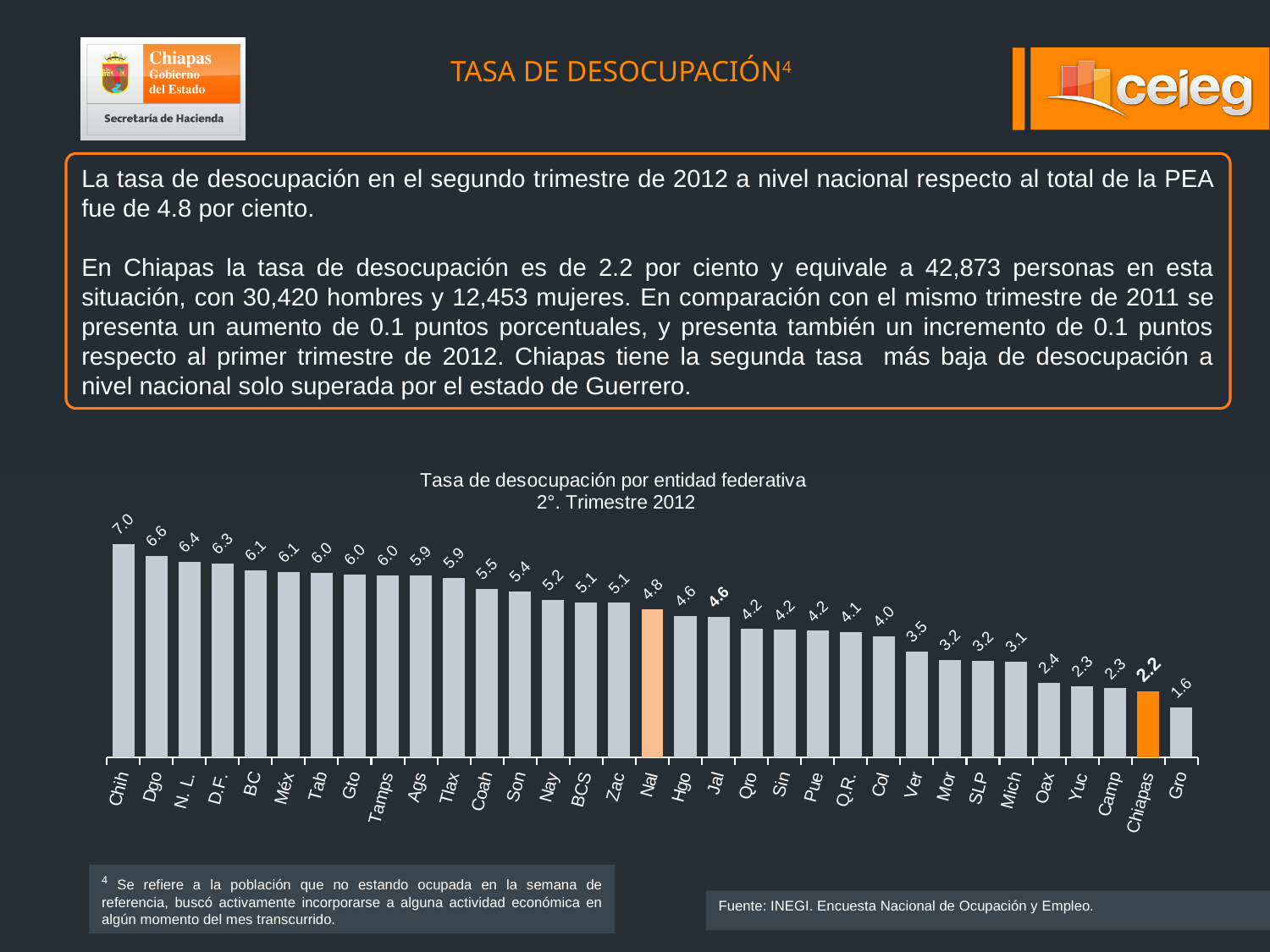
What is the value for Nal (national) in the chart? 4.8 Which entity has the highest unemployment rate in the chart? Chih What is the value for Chiapas in the chart? 2.2 What is the difference between the national value (Nal) and the value for Chiapas? 2.6 Which has a higher value, Dgo or Ver? Dgo Which bar is highlighted in dark orange in the chart? Chiapas Do the values rise or fall from left to right along the x axis? Fall What kind of chart is shown on the slide? Bar chart What is the value for Chih in the chart? 7.0 What is the difference between the values for Chih and Gro? 5.4 How many bars are plotted in the chart? 33 Which entity has the lowest unemployment rate in the chart? Gro